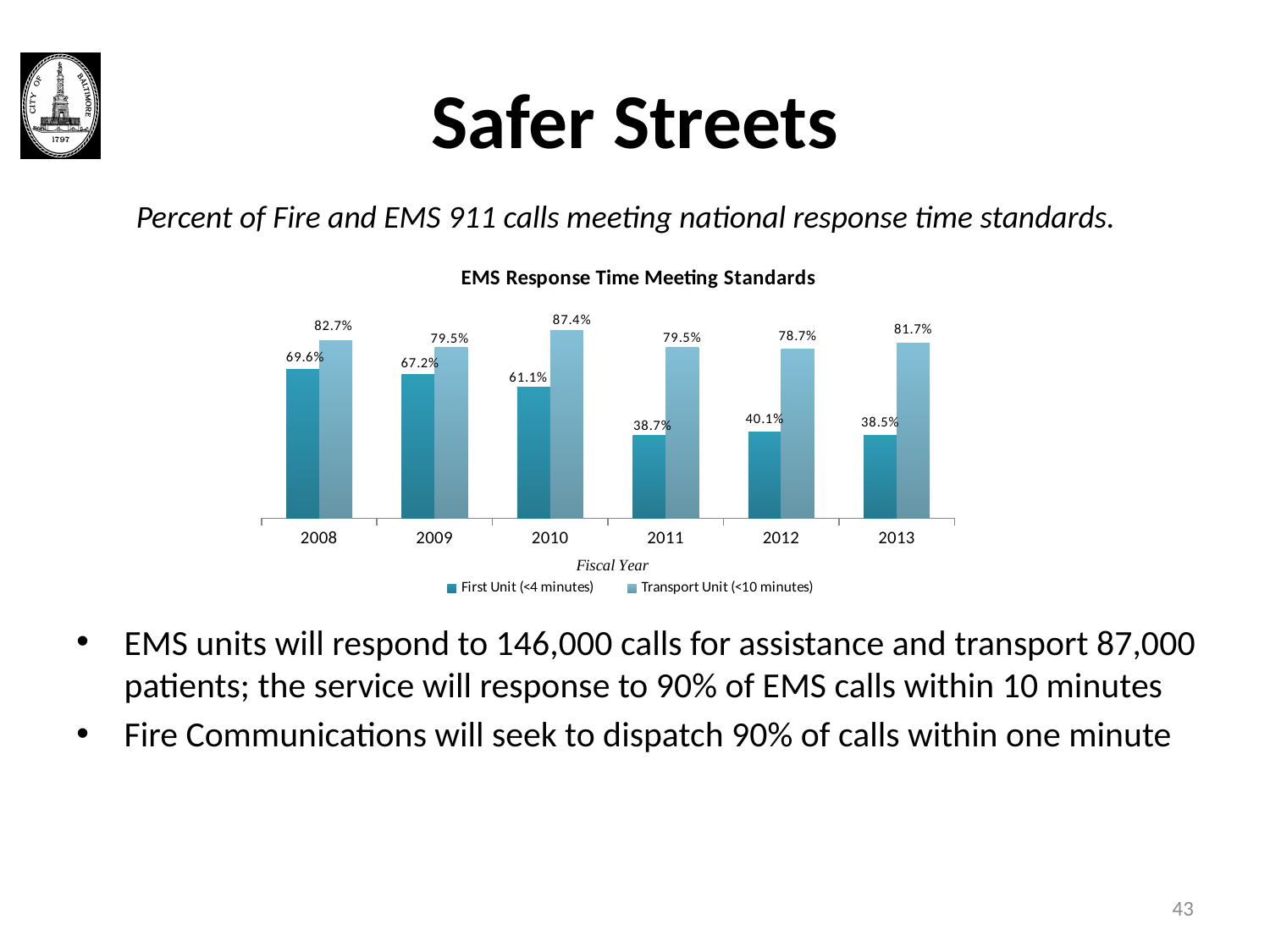
How many series does the legend list? 2 Which fiscal year has the highest Transport Unit (<10 minutes) value? 2010 What is the label of the x axis? Fiscal Year What kind of chart is shown? Bar chart Which fiscal year has the lowest First Unit (<4 minutes) value? 2013 What is the First Unit (<4 minutes) value for fiscal year 2010? 61.1% What is the Transport Unit (<10 minutes) value for fiscal year 2013? 81.7% What is the difference between the Transport Unit and First Unit values in 2011? 40.8% How many fiscal years are shown on the x axis? 6 Which is larger, the First Unit value in 2008 or the First Unit value in 2012? 2008 What is the title of the chart? EMS Response Time Meeting Standards Does the First Unit (<4 minutes) value rise or fall from 2008 to 2011? Fall